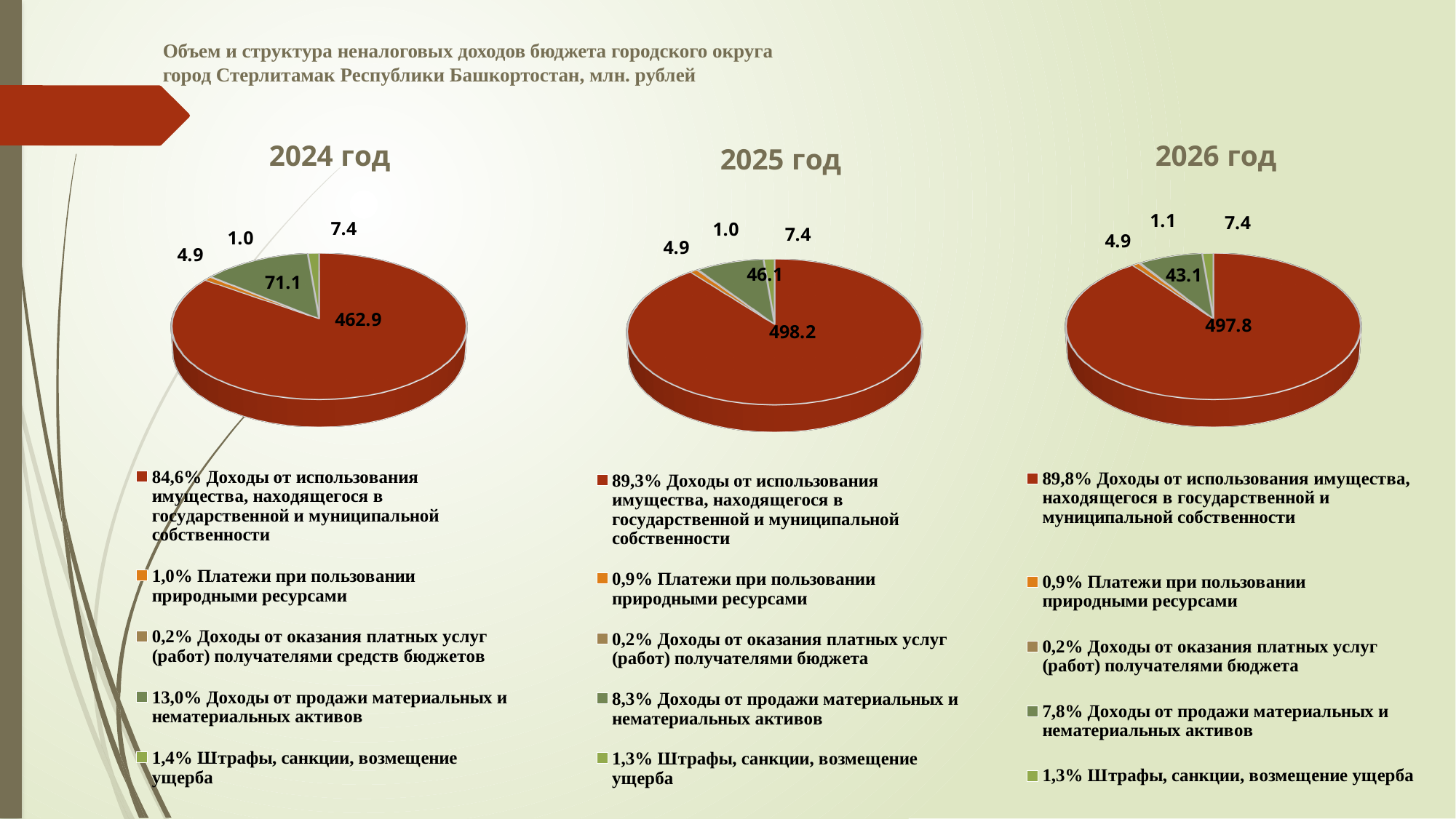
Which is larger: the sale-of-assets slice in the 2024 год chart or in the 2026 год chart? 2024 год (71.1) In the 2024 год chart, which category has the largest slice? Доходы от использования имущества, находящегося в государственной и муниципальной собственности How many pie charts are on the slide? 3 What kind of charts are shown on the slide? Pie charts What is the difference between the largest slice in the 2025 год chart (498.2) and the largest slice in the 2024 год chart (462.9)? 35.3 In the 2026 год chart, what is the value of the largest slice? 497.8 According to the legend of the 2026 год chart, what share of the pie is income from sale of material and non-material assets? 7,8% In the 2024 год chart, what is the value of the largest slice (income from use of state and municipal property)? 462.9 According to the legend of the 2025 год chart, what share of the pie is income from use of state and municipal property? 89,3% How many categories does the legend of each pie chart list? 5 In the 2025 год chart, what is the value of the slice for income from sale of material and non-material assets (Доходы от продажи материальных и нематериальных активов)? 46.1 In the 2026 год chart, what is the smallest labelled value? 1.1